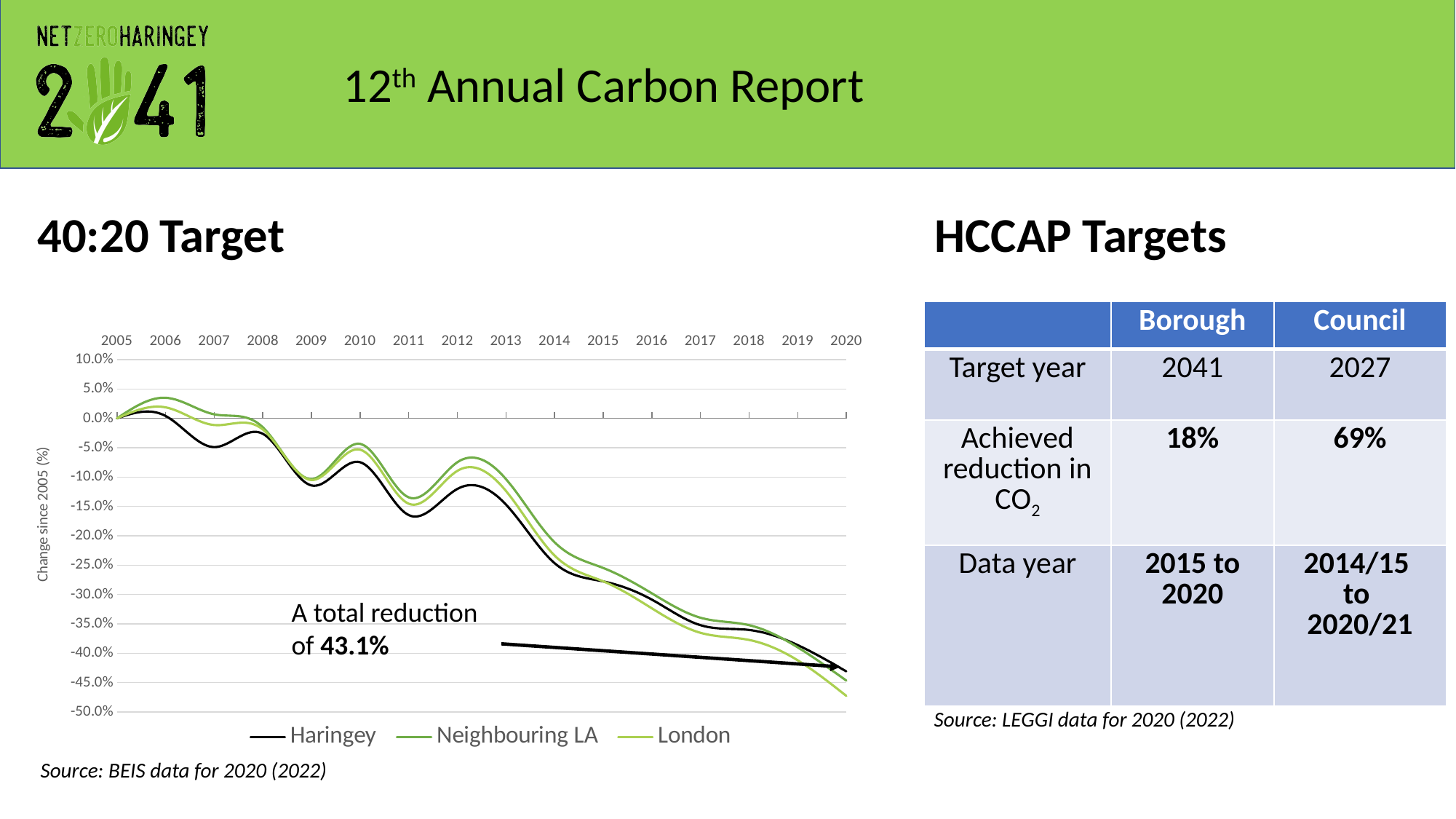
What total reduction does the annotation on the 40:20 Target chart state? 43.1% What is the label on the y axis of the 40:20 Target chart? Change since 2005 (%) How many years are shown along the x axis of the 40:20 Target chart? 16 How many series does the legend of the 40:20 Target chart list? 3 Which series in the 40:20 Target chart is drawn with a black line? Haringey In the 40:20 Target chart, is the Haringey value for 2020 greater or less than -40.0%? less In the 40:20 Target chart, is the Haringey value for 2011 greater or less than -15.0%? less In the 40:20 Target chart, which series reaches the lowest value in 2020? London In the 40:20 Target chart, is the Neighbouring LA value for 2010 greater or less than -10.0%? greater In the 40:20 Target chart, do the values generally rise or fall from 2005 to 2020? fall What kind of chart is shown under the heading "40:20 Target"? line chart